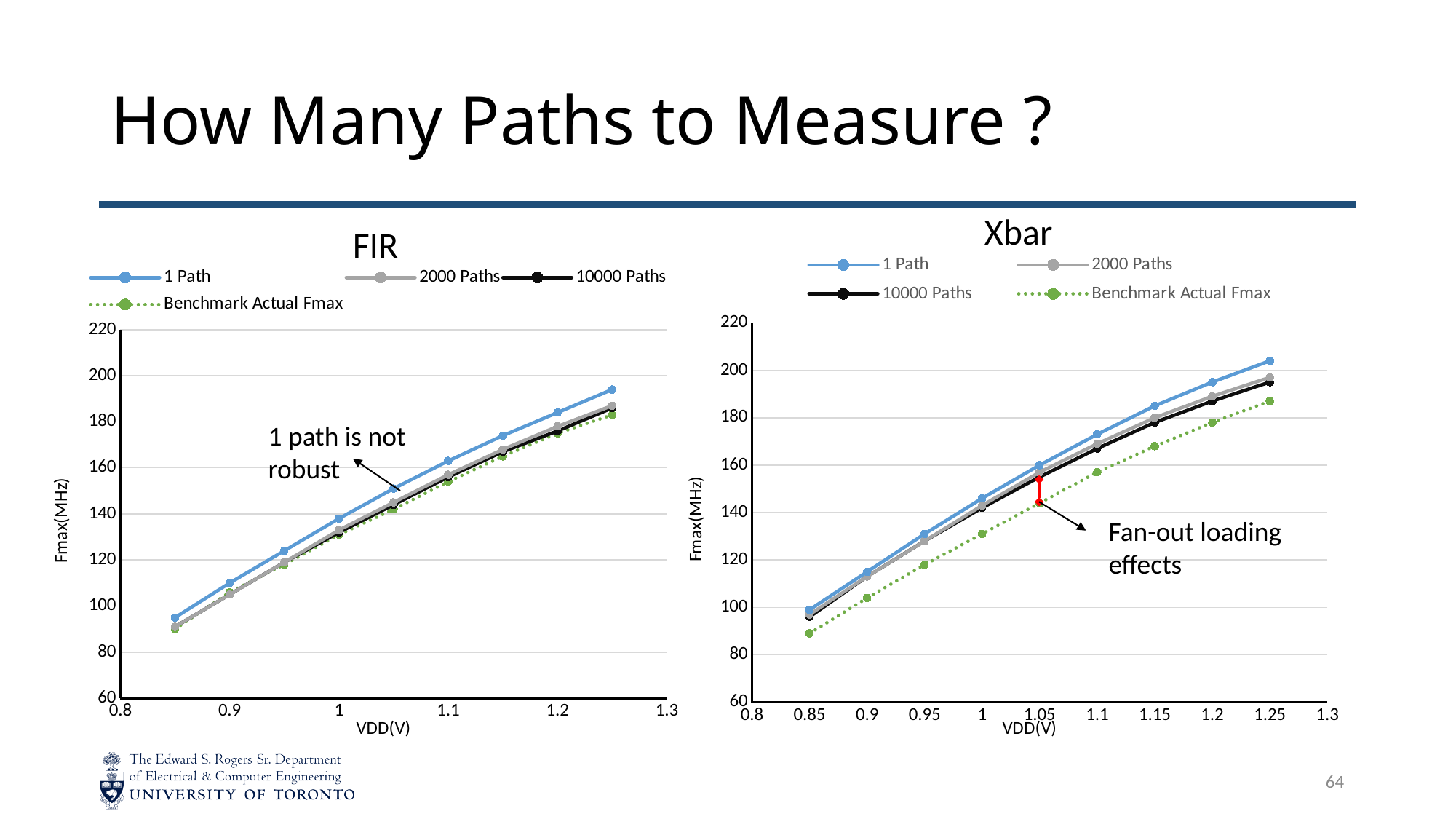
In the Xbar chart, is the 1 Path value at VDD 1 V greater or less than 140? greater What type of chart is the FIR chart? line chart How many data points does the 1 Path series have in the FIR chart? 9 In the FIR chart, which series has the highest Fmax at VDD 1.25 V? 1 Path What is the y-axis label of the FIR chart? Fmax(MHz) In the Xbar chart, which series has the lowest Fmax at VDD 1.05 V? Benchmark Actual Fmax How many series does the legend of the Xbar chart list? 4 In the FIR chart, is the Benchmark Actual Fmax value at VDD 0.85 V greater or less than 100? less Which series in the Xbar chart is drawn with a dotted green line? Benchmark Actual Fmax In the Xbar chart, is the 1 Path value at VDD 1.25 V greater or less than 200? greater In the Xbar chart, at VDD 1.05 V, which is larger: 1 Path or Benchmark Actual Fmax? 1 Path In the Xbar chart, does Fmax rise or fall as VDD increases? rise